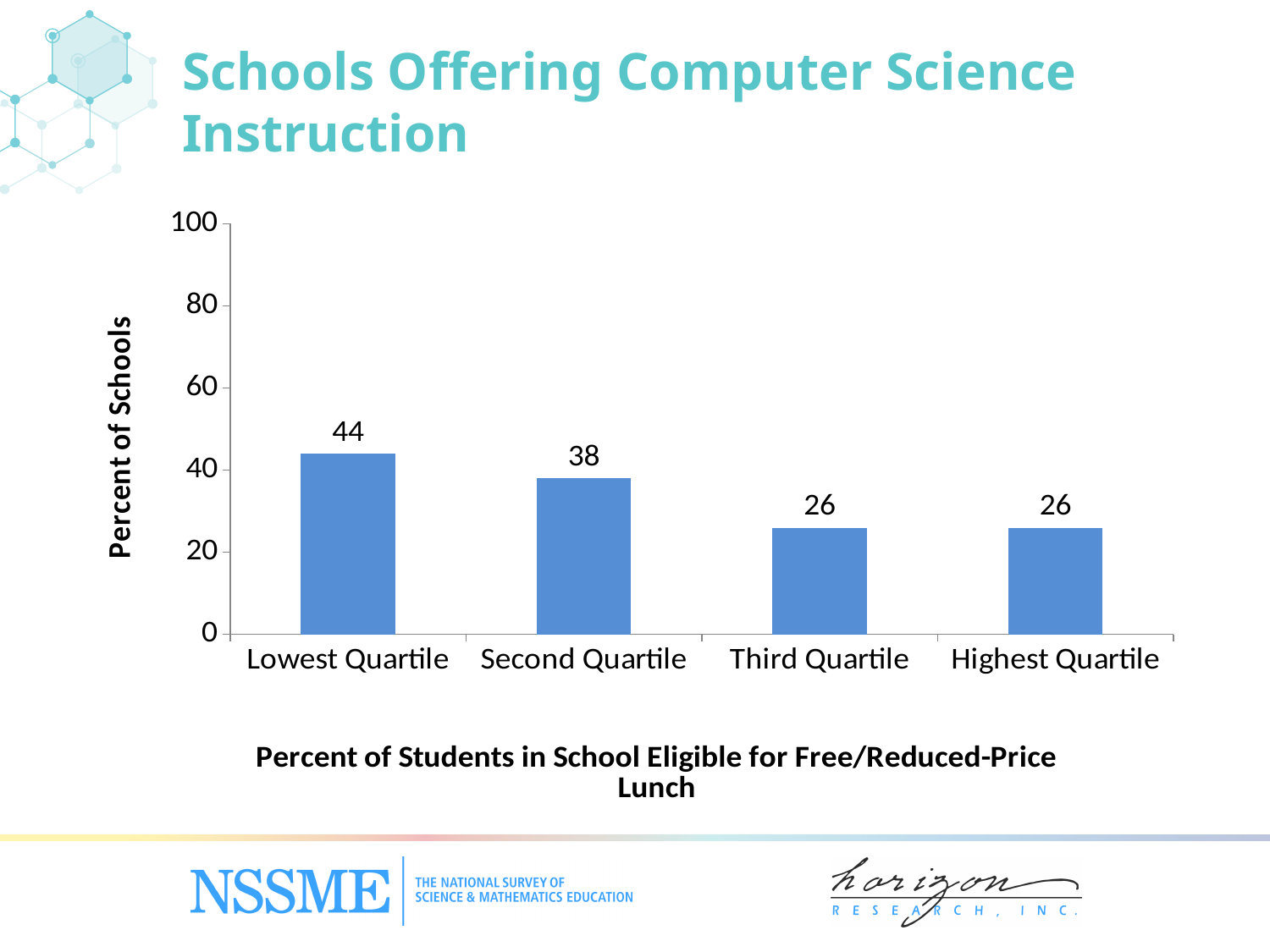
What kind of chart is shown on the slide? bar chart How many categories are shown on the x axis? 4 What is the difference between the values for Lowest Quartile and Highest Quartile? 18 What is the difference between the values for Lowest Quartile and Second Quartile? 6 Do the values rise or fall from Lowest Quartile to Third Quartile? fall What is the value for Lowest Quartile? 44 What is the value for Second Quartile? 38 Is the value for Second Quartile greater or less than 40? less Which category has the highest value? Lowest Quartile What is the label of the y axis? Percent of Schools What is the value for Third Quartile? 26 Which is larger, the value for Second Quartile or the value for Third Quartile? Second Quartile